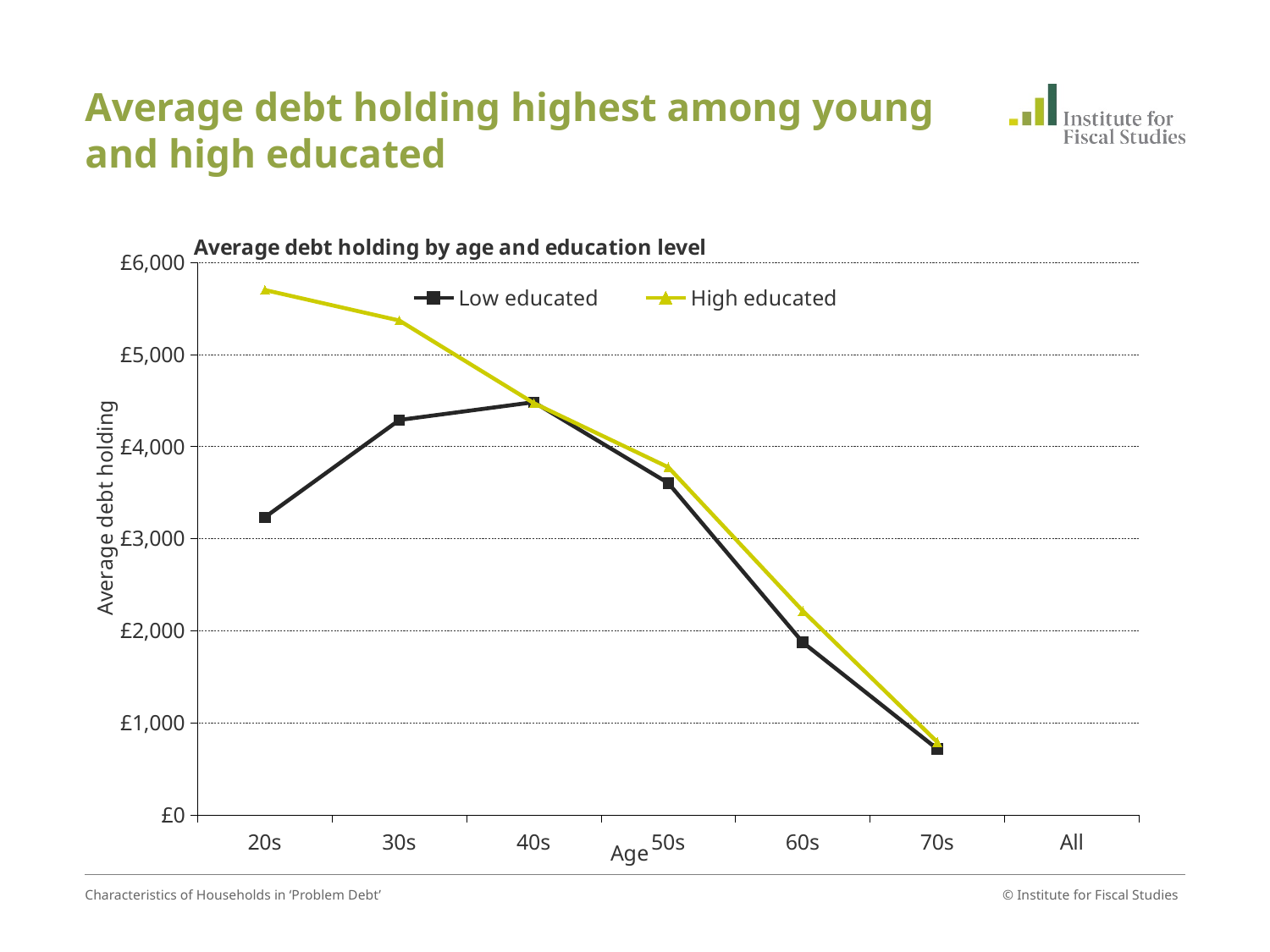
What is the title of the chart? Average debt holding by age and education level How many series does the legend list? 2 In the 20s age group, which series has the larger average debt holding, Low educated or High educated? High educated Does the average debt holding for the High educated series rise or fall as age increases from 20s to 70s? Fall Which two series are listed in the legend? Low educated and High educated Which age group has the highest average debt holding for the Low educated series? 40s What kind of chart is shown on the slide? Line chart Is the average debt holding for Low educated in their 60s greater or less than £2,000? less Is the average debt holding for High educated in their 20s greater or less than £5,000? greater Which age group has the lowest average debt holding for the Low educated series? 70s How many data points are plotted for the High educated series? 6 Which age group has the highest average debt holding for the High educated series? 20s